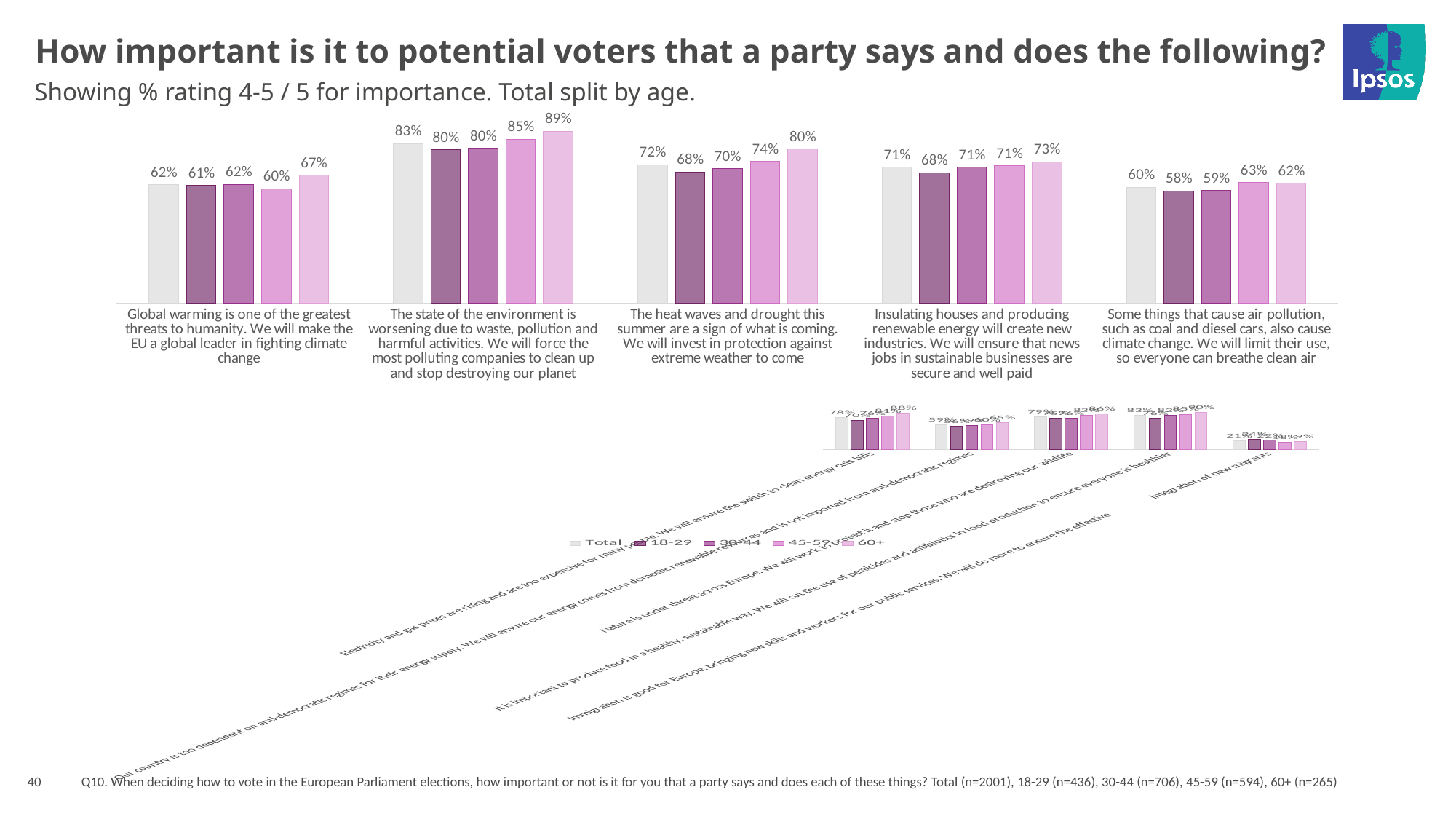
How many statements (categories) are shown in the top chart? 5 In the top chart, what is the difference between the 60+ and 18-29 values for "The heat waves and drought this summer are a sign of what is coming..."? 12 percentage points What kind of chart is the top chart? Bar chart In the top chart, what is the 60+ value for "The heat waves and drought this summer are a sign of what is coming..."? 80% In the top chart, which statement has the highest Total value? The state of the environment is worsening due to waste, pollution and harmful activities. We will force the most polluting companies to clean up and stop destroying our planet In the top chart, which statement has the lowest Total value? Some things that cause air pollution, such as coal and diesel cars, also cause climate change. We will limit their use, so everyone can breathe clean air Which age group is shown by the grey bars in the top chart? Total In the top chart, what is the 18-29 value for "Some things that cause air pollution, such as coal and diesel cars, also cause climate change..."? 58% In the top chart, what is the Total value for "The state of the environment is worsening due to waste, pollution and harmful activities..."? 83% In the top chart, what is the 45-59 value for "Global warming is one of the greatest threats to humanity..."? 60% In the top chart, for "Insulating houses and producing renewable energy will create new industries...", which is larger: the 60+ value or the 18-29 value? 60+ How many series does the legend list? 5